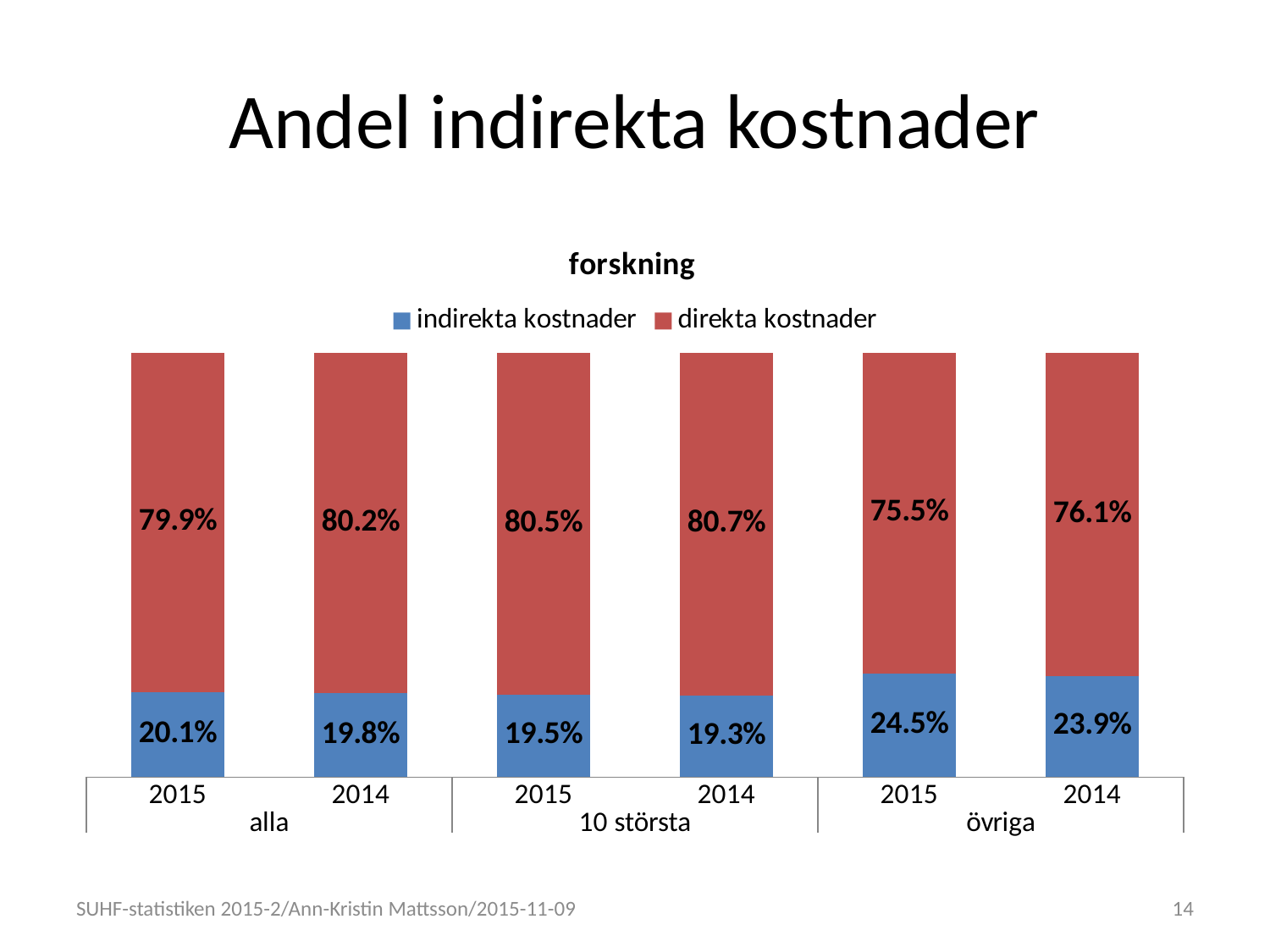
What is the difference between the indirekta kostnader share for övriga in 2015 and övriga in 2014? 0.6% What kind of chart is shown on the slide? stacked bar chart How many series does the legend list? 2 What is the value of direkta kostnader for 10 största in 2014? 80.7% Which is larger: the indirekta kostnader share for alla in 2015 or for 10 största in 2015? alla 2015 Which group and year has the lowest share of indirekta kostnader? 10 största 2014 What is the value of indirekta kostnader for alla in 2015? 20.1% How many bars are shown in the chart? 6 Which group and year has the highest share of indirekta kostnader? övriga 2015 What is the value of indirekta kostnader for övriga in 2015? 24.5% What is the total of the stacked bar for alla in 2014? 100% What is the title of the chart? forskning